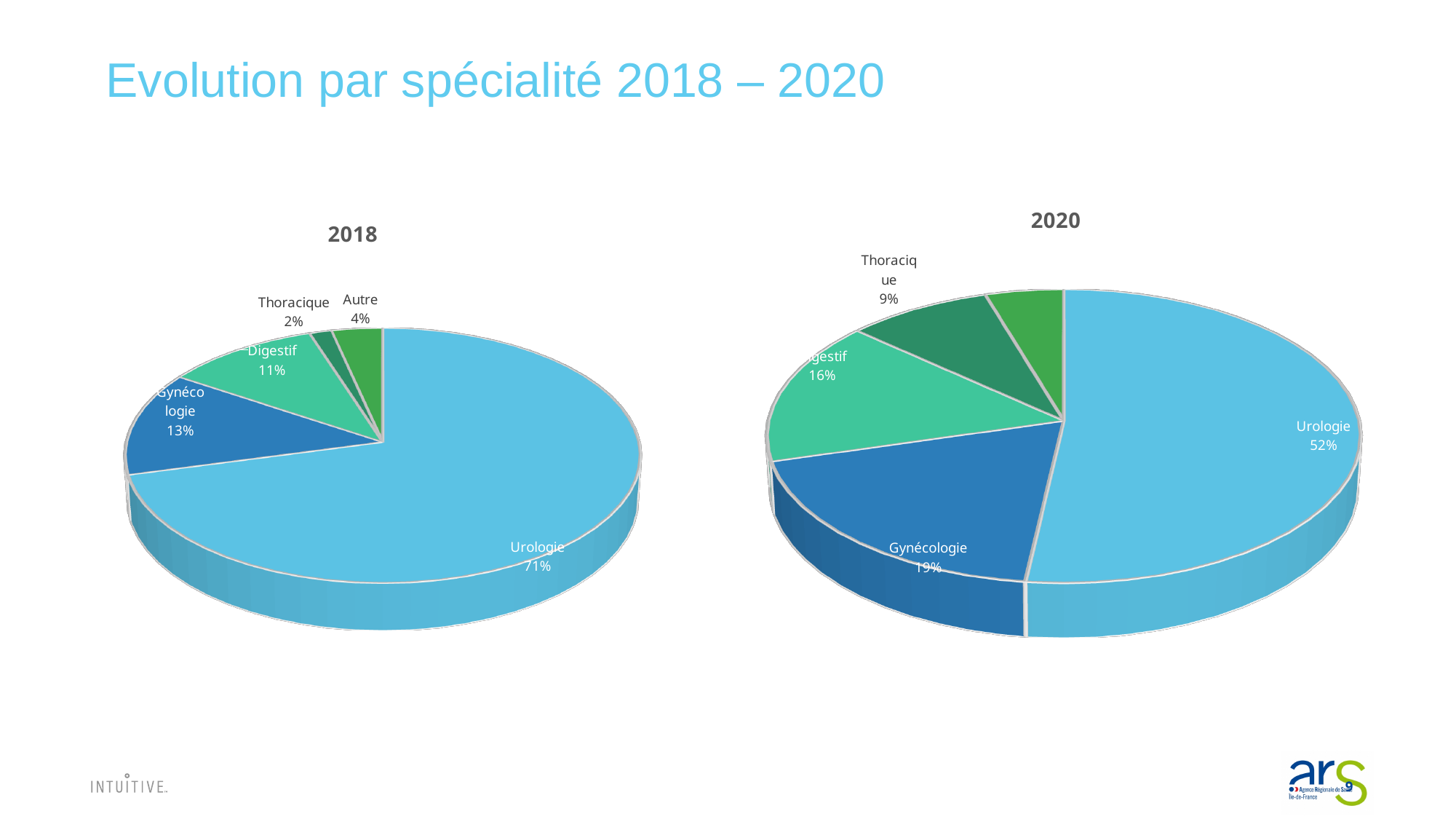
In the 2018 chart, what is the difference between Gynécologie and Digestif? 2 percentage points How many slices does the 2018 pie chart have? 5 In the 2018 chart, what share does Urologie have? 71% What is the title of the slide? Evolution par spécialité 2018 – 2020 In the 2020 chart, what share does Urologie have? 52% In the 2018 chart, what is the value for Gynécologie? 13% In the 2020 chart, what is the value for Digestif? 16% What type of chart is used for the 2018 data? Pie chart In the 2018 chart, which specialty has the smallest share? Thoracique What is the difference between the Urologie share in 2018 and in 2020? 19 percentage points In the 2020 chart, which is larger: Gynécologie or Digestif? Gynécologie In the 2020 chart, which labelled specialty has the largest share? Urologie